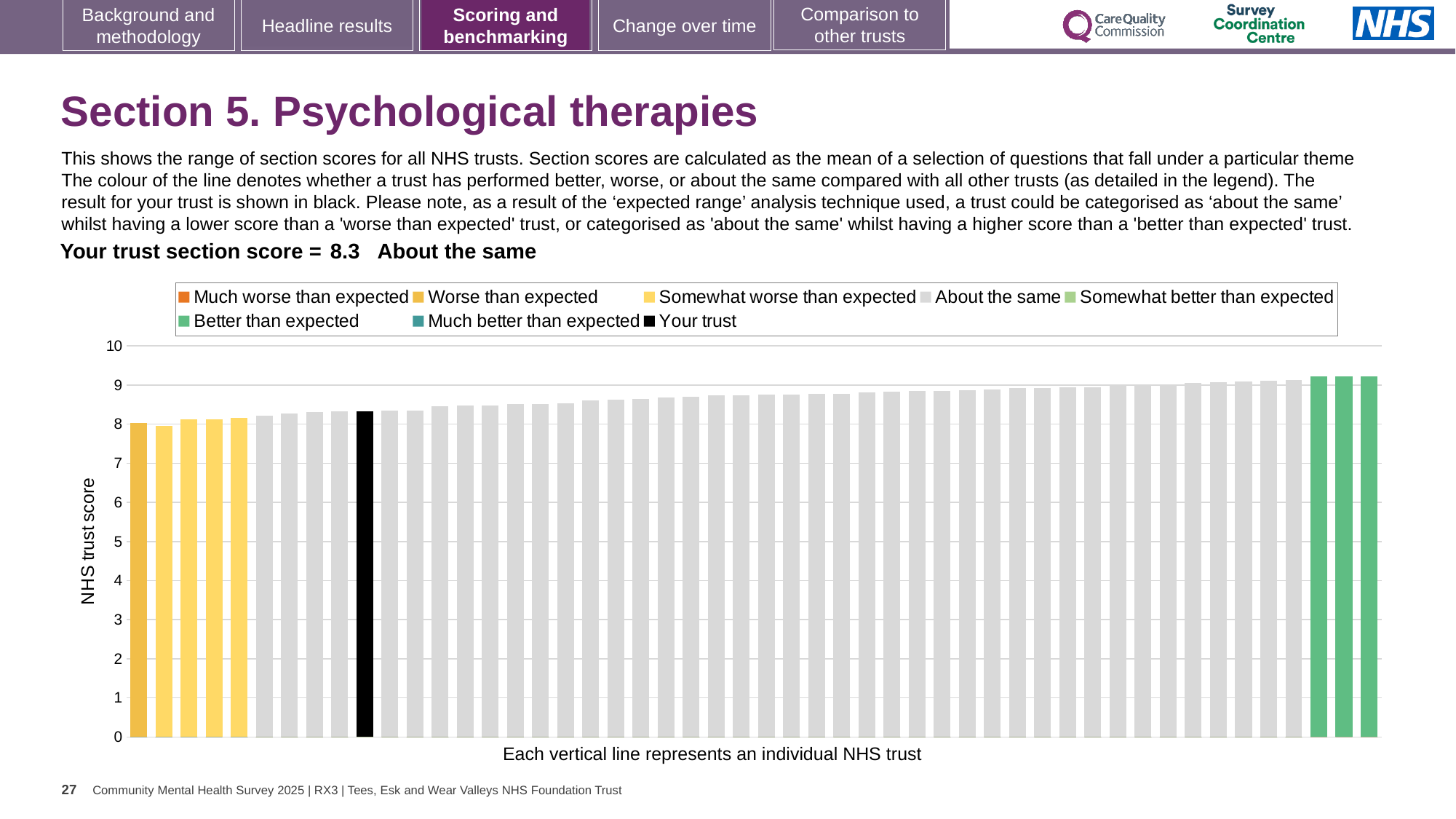
What is the section score for your trust? 8.3 Is the value of the shortest bar greater or less than 7? greater What is the label on the vertical axis? NHS trust score Is the value for your trust (the black bar) greater or less than 9? less How many entries does the chart legend list? 8 Which legend category is shown in black? Your trust Is the value of the tallest bar greater or less than 9? greater How many bars are coloured green? 3 Do the bar values rise or fall from left to right along the x axis? rise What kind of chart is shown on the slide? bar chart How many bars are coloured black? 1